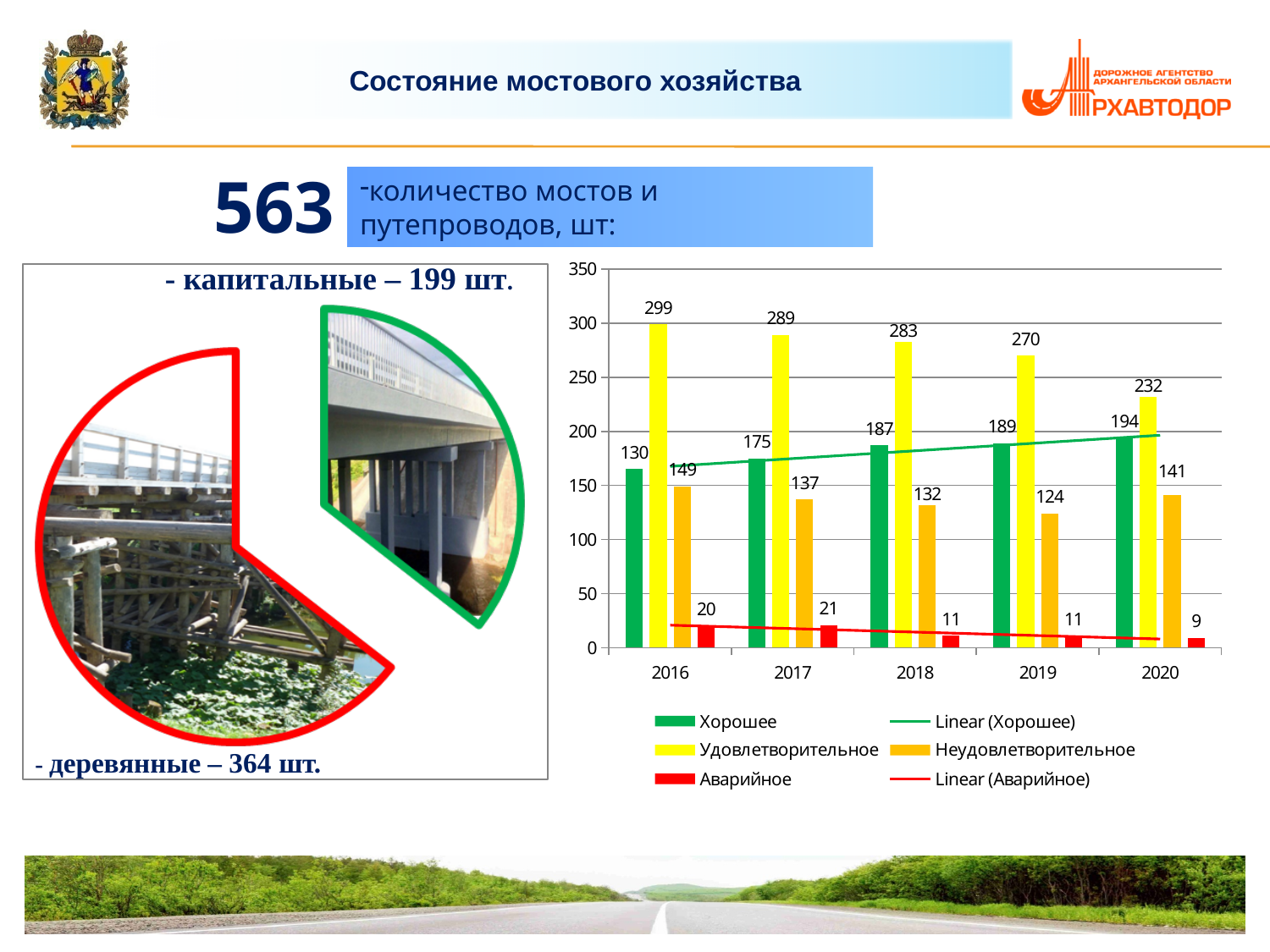
In the bar chart, in which year is the Удовлетворительное value highest? 2016 In the bar chart, by how much did the Хорошее value increase from 2016 to 2020? 64 What kind of chart is shown on the right side of the slide? bar chart In the bar chart, what is the value for Хорошее in 2016? 130 In the bar chart, what is the value for Удовлетворительное in 2020? 232 In the bar chart, how many years are shown on the x axis? 5 In the bar chart, how many entries does the legend list? 6 In the bar chart, which is larger in 2018: Хорошее or Неудовлетворительное? Хорошее In the bar chart, in which year is the Аварийное value lowest? 2020 In the bar chart, what is the value for Аварийное in 2017? 21 In the pie chart on the left, how many bridges are деревянные? 364 шт. In the bar chart, does the Удовлетворительное value rise or fall from 2016 to 2020? fall